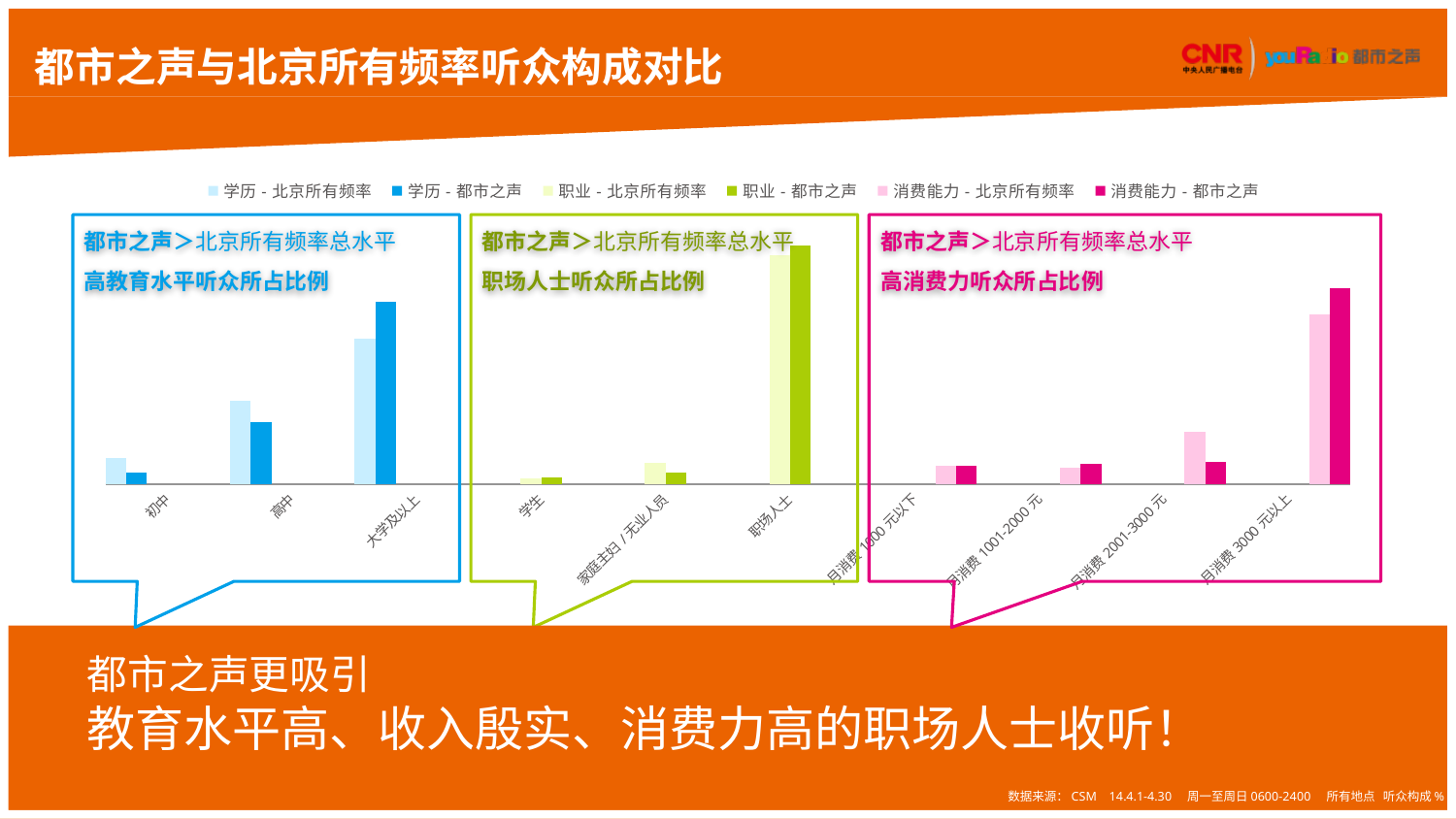
What kind of chart is shown on the slide? bar chart What is the title of the slide containing the chart? 都市之声与北京所有频率听众构成对比 Among the 学历 categories (初中, 高中, 大学及以上), which has the lowest 学历 - 都市之声 bar? 初中 Among the 消费能力 categories, which has the highest 消费能力 - 都市之声 bar? 月消费 3000 元以上 How many series does the legend list? 6 Do the 学历 - 都市之声 values rise or fall from 初中 to 大学及以上? rise For 大学及以上, which is larger: 学历 - 北京所有频率 or 学历 - 都市之声? 学历 - 都市之声 For 高中, which is larger: 学历 - 北京所有频率 or 学历 - 都市之声? 学历 - 北京所有频率 For 日消费 2001-3000 元, which is larger: 消费能力 - 北京所有频率 or 消费能力 - 都市之声? 消费能力 - 北京所有频率 How many categories are shown along the x axis of the chart? 10 Among the 学历 categories (初中, 高中, 大学及以上), which has the highest 学历 - 都市之声 bar? 大学及以上 Among the 职业 categories (学生, 家庭主妇/无业人员, 职场人士), which has the lowest 职业 - 北京所有频率 bar? 学生